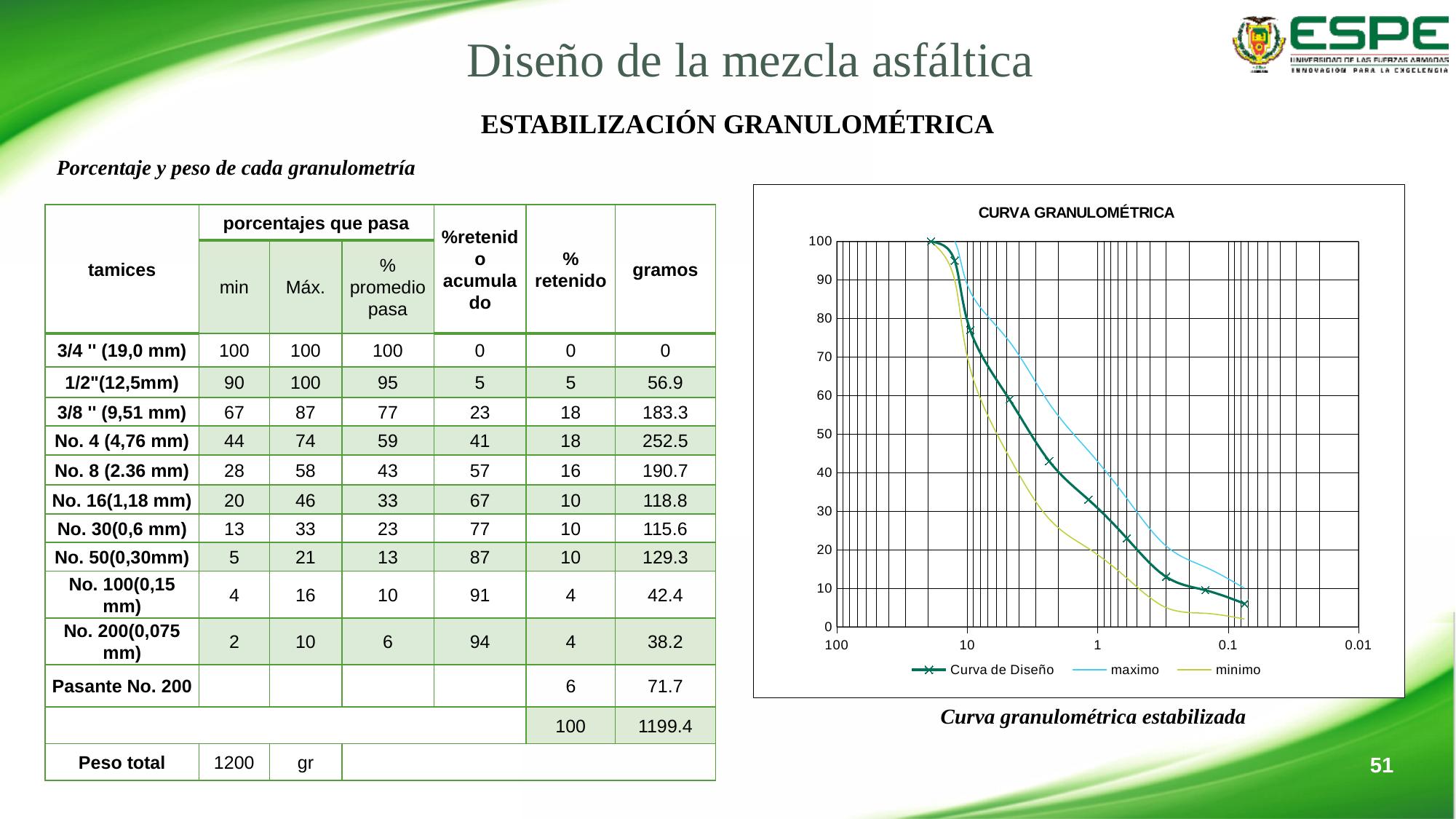
What is the title of the chart on the slide? CURVA GRANULOMÉTRICA At x = 1 on the chart, which of the three series has the highest value? maximo What is the highest value reached by the Curva de Diseño series? 100 At x = 1 on the chart, is the value of the minimo series greater or less than 30? less At x = 0.1 on the chart, is the value of the minimo series greater or less than 10? less Do the values of the Curva de Diseño series rise or fall moving from left to right along the x axis? fall What kind of chart is shown on the slide? line chart At x = 1 on the chart, which series has the larger value, maximo or minimo? maximo At x = 10 on the chart, is the value of the Curva de Diseño series greater or less than 50? greater Which series in the chart is drawn with x-shaped markers? Curva de Diseño How many series does the legend of the CURVA GRANULOMÉTRICA chart list? 3